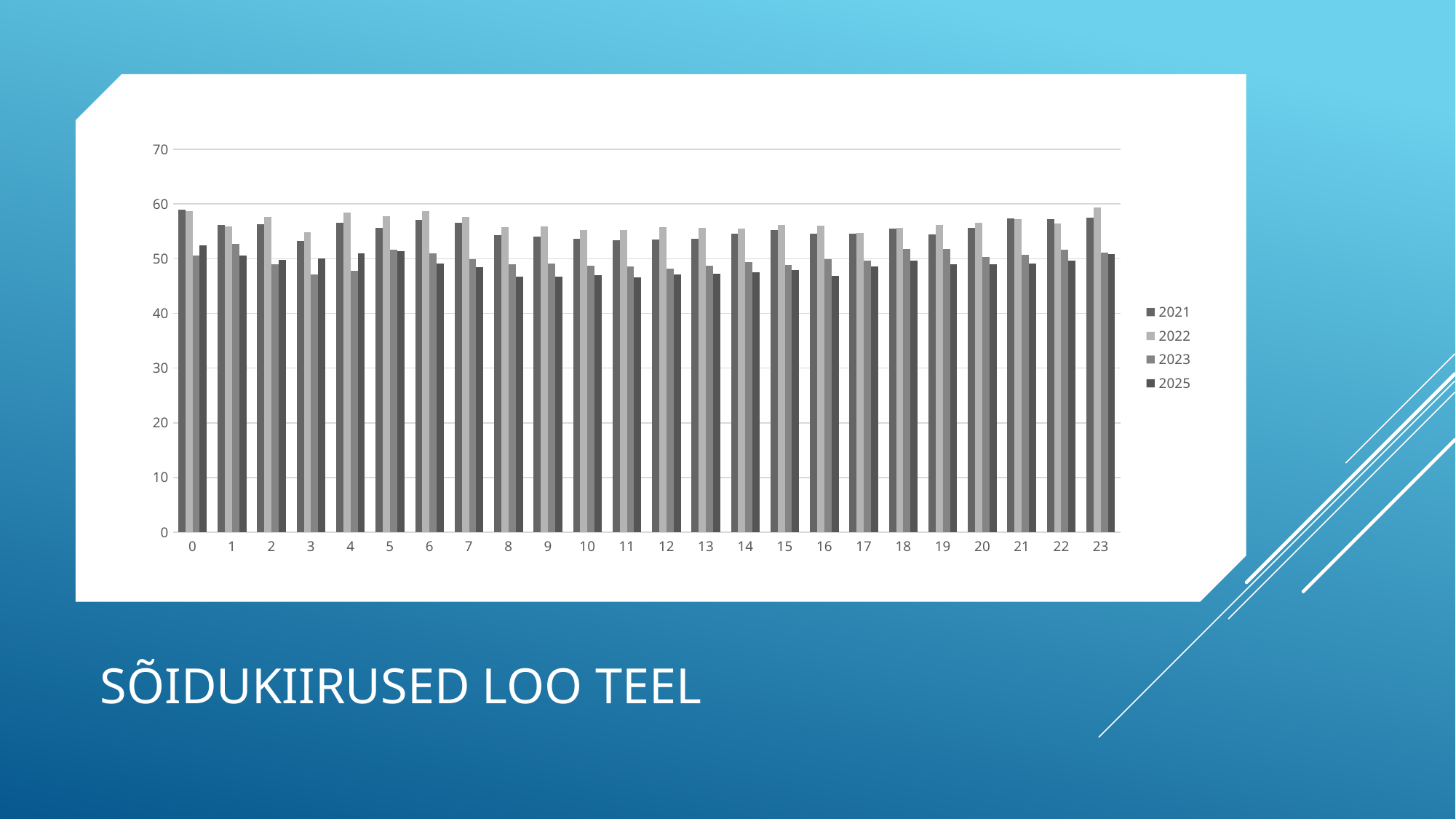
What kind of chart is shown on the slide? bar chart How many series does the chart's legend list? 4 Is the value for 2021 at category 0 greater or less than 50? greater Is the value for 2022 at category 6 greater or less than 50? greater Is the value for 2023 at category 3 greater or less than 50? less Which years are listed in the chart's legend? 2021, 2022, 2023, 2025 At category 0, which series has the larger value, 2021 or 2025? 2021 What is the title shown on the slide below the chart? SÕIDUKIIRUSED LOO TEEL At category 23, which series has the larger value, 2022 or 2025? 2022 How many categories are shown along the x axis of the chart? 24